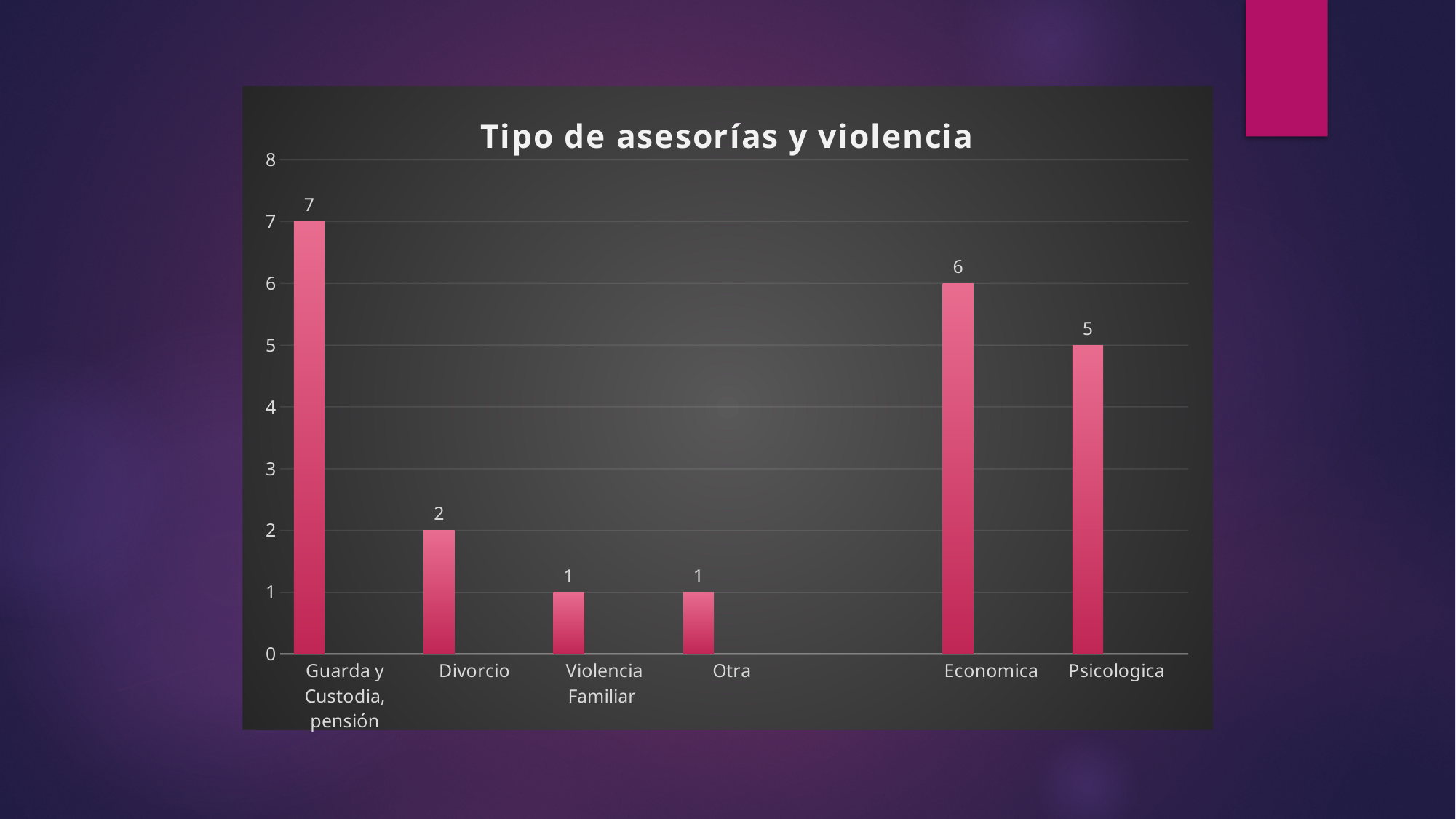
Which is larger, the value for Divorcio or the value for Otra? Divorcio What is the value for Guarda y Custodia, pensión? 7 What is the difference between the values for Psicologica and Divorcio? 3 How many bars are plotted in the chart? 6 Which is larger, the value for Economica or the value for Psicologica? Economica Which category has the highest value? Guarda y Custodia, pensión What is the value for Psicologica? 5 What is the value for Divorcio? 2 What is the title of the chart? Tipo de asesorías y violencia What kind of chart is shown on the slide? Bar chart What is the value for Economica? 6 What is the difference between the values for Guarda y Custodia, pensión and Economica? 1